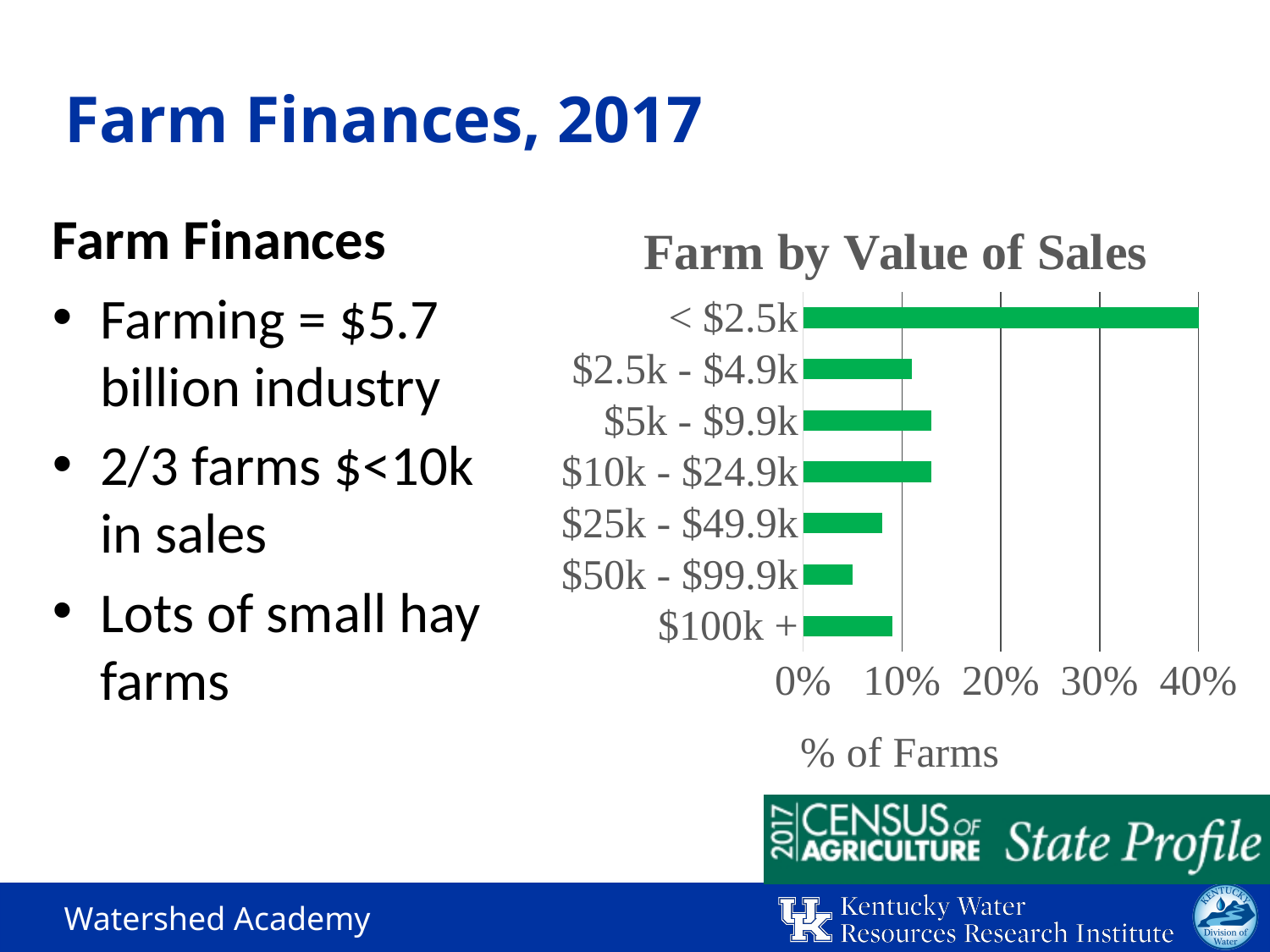
Which has a higher percentage of farms: $2.5k - $4.9k or $50k - $99.9k? $2.5k - $4.9k Is the value for < $2.5k greater or less than 30%? greater Is the value for $5k - $9.9k greater or less than 10%? greater What kind of chart is shown on the slide? bar chart Which sales-value category has the lowest percentage of farms? $50k - $99.9k Which has a higher percentage of farms: $100k + or $50k - $99.9k? $100k + What is the title of the chart? Farm by Value of Sales Which sales-value category has the highest percentage of farms? < $2.5k Is the value for $25k - $49.9k greater or less than 10%? less What is the label on the horizontal axis of the chart? % of Farms How many sales-value categories are plotted in the chart? 7